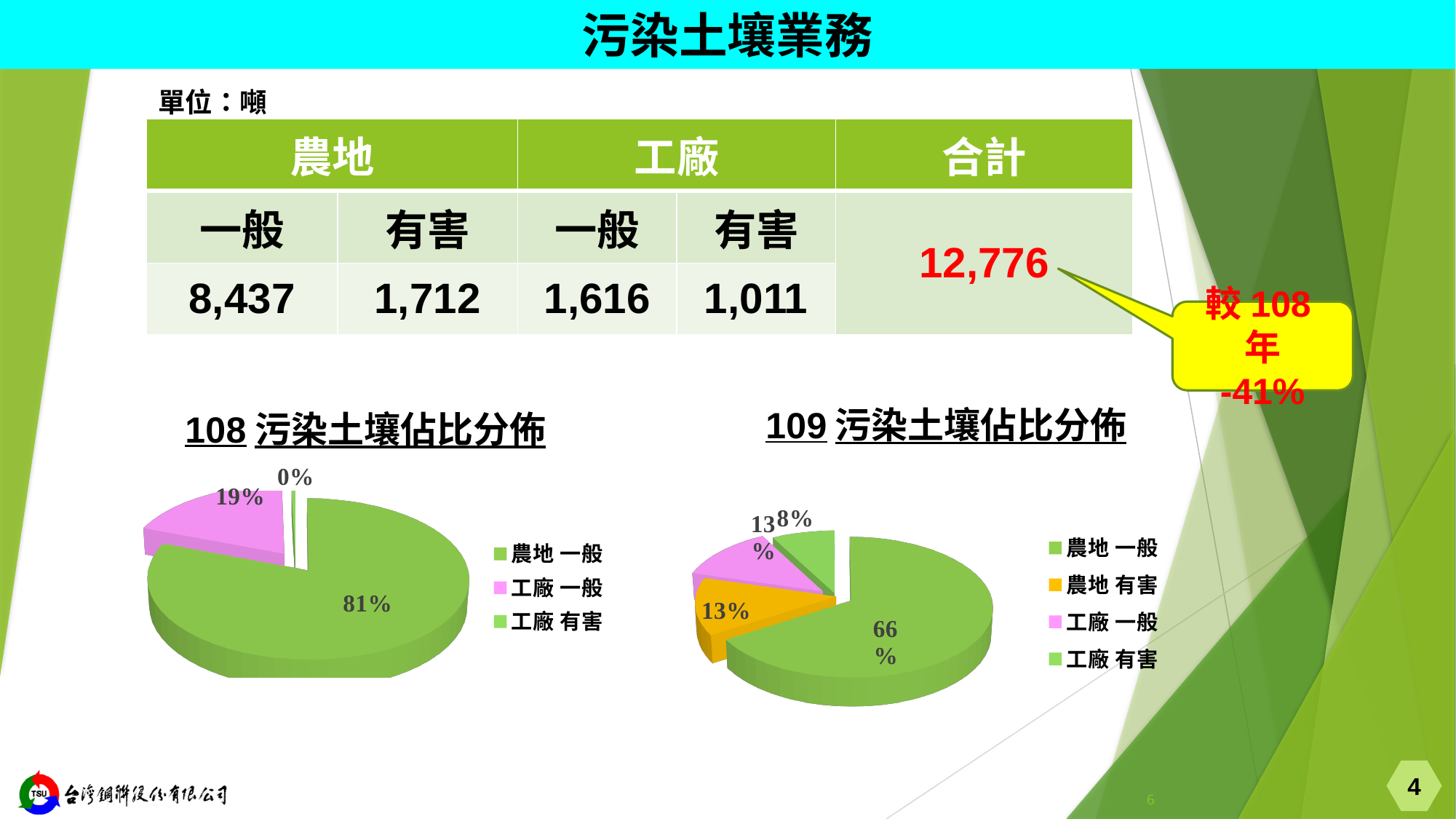
In the "108 污染土壤佔比分佈" chart, what share does 工廠 有害 have? 0% In the "109 污染土壤佔比分佈" chart, what share does 農地 有害 have? 13% How many entries does the legend of the "108 污染土壤佔比分佈" chart list? 3 In the "108 污染土壤佔比分佈" chart, which category has the largest slice? 農地 一般 In the "109 污染土壤佔比分佈" chart, which category has the smallest slice? 工廠 有害 In the "108 污染土壤佔比分佈" chart, what share does 農地 一般 have? 81% What kind of chart is the "108 污染土壤佔比分佈" chart? pie chart How many entries does the legend of the "109 污染土壤佔比分佈" chart list? 4 In the "109 污染土壤佔比分佈" chart, what is the difference between the shares of 農地 一般 and 工廠 有害? 58%